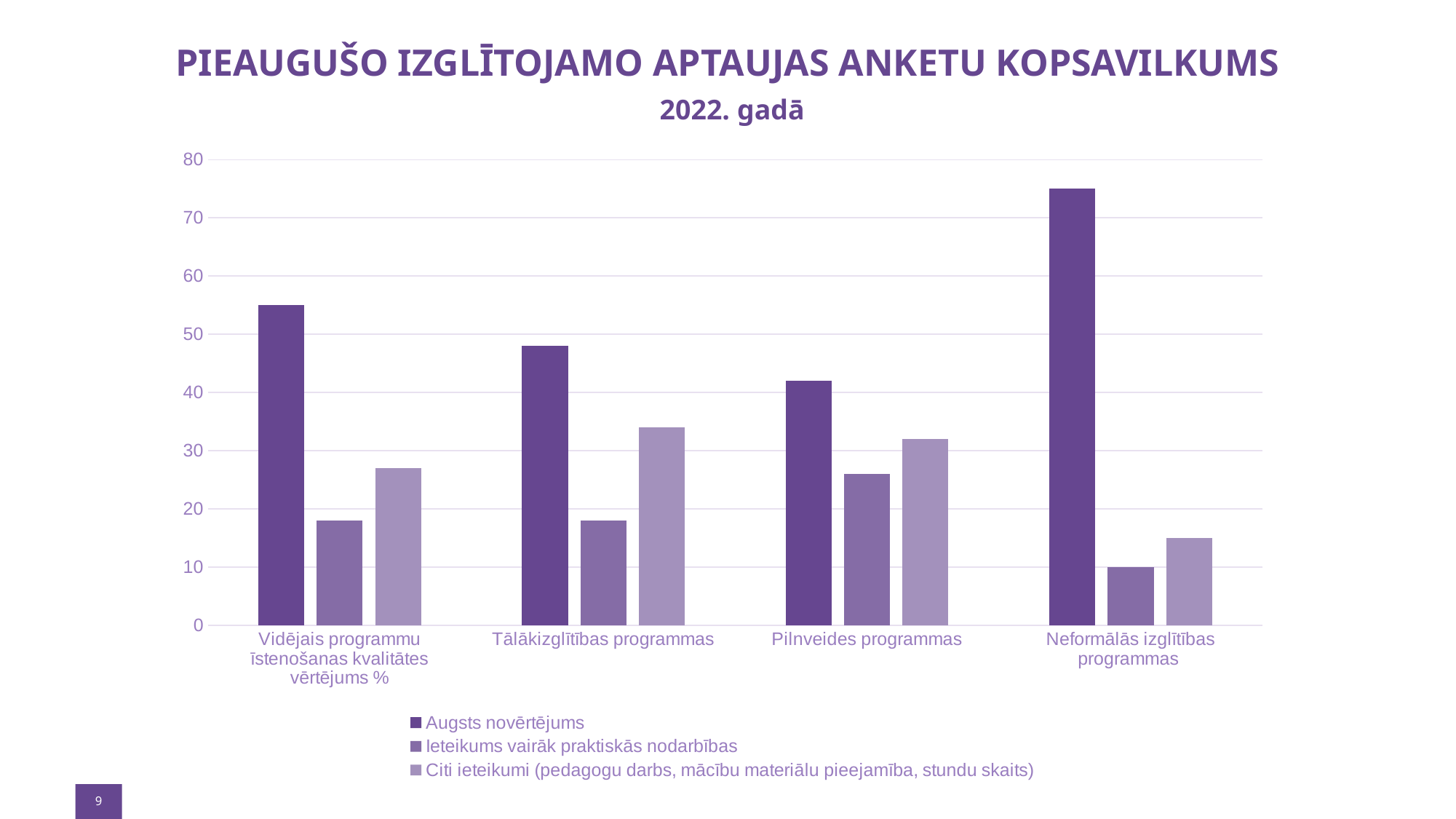
Which category has the highest value for Augsts novērtējums? Neformālās izglītības programmas Which is larger for Pilnveides programmas: Ieteikums vairāk praktiskās nodarbības or Citi ieteikumi? Citi ieteikumi Which category has the highest value for Citi ieteikumi (pedagogu darbs, mācību materiālu pieejamība, stundu skaits)? Tālākizglītības programmas How many categories are shown on the x axis? 4 Which category has the lowest value for Ieteikums vairāk praktiskās nodarbības? Neformālās izglītības programmas Is the value for Citi ieteikumi in Vidējais programmu īstenošanas kvalitātes vērtējums % greater or less than 30? less What kind of chart is shown on the slide? bar chart Which category has the lowest value for Augsts novērtējums? Pilnveides programmas Is the value for Augsts novērtējums in Pilnveides programmas greater or less than 50? less What year is given in the chart subtitle? 2022. gadā How many series does the legend list? 3 Is the value for Augsts novērtējums in Neformālās izglītības programmas greater or less than 70? greater